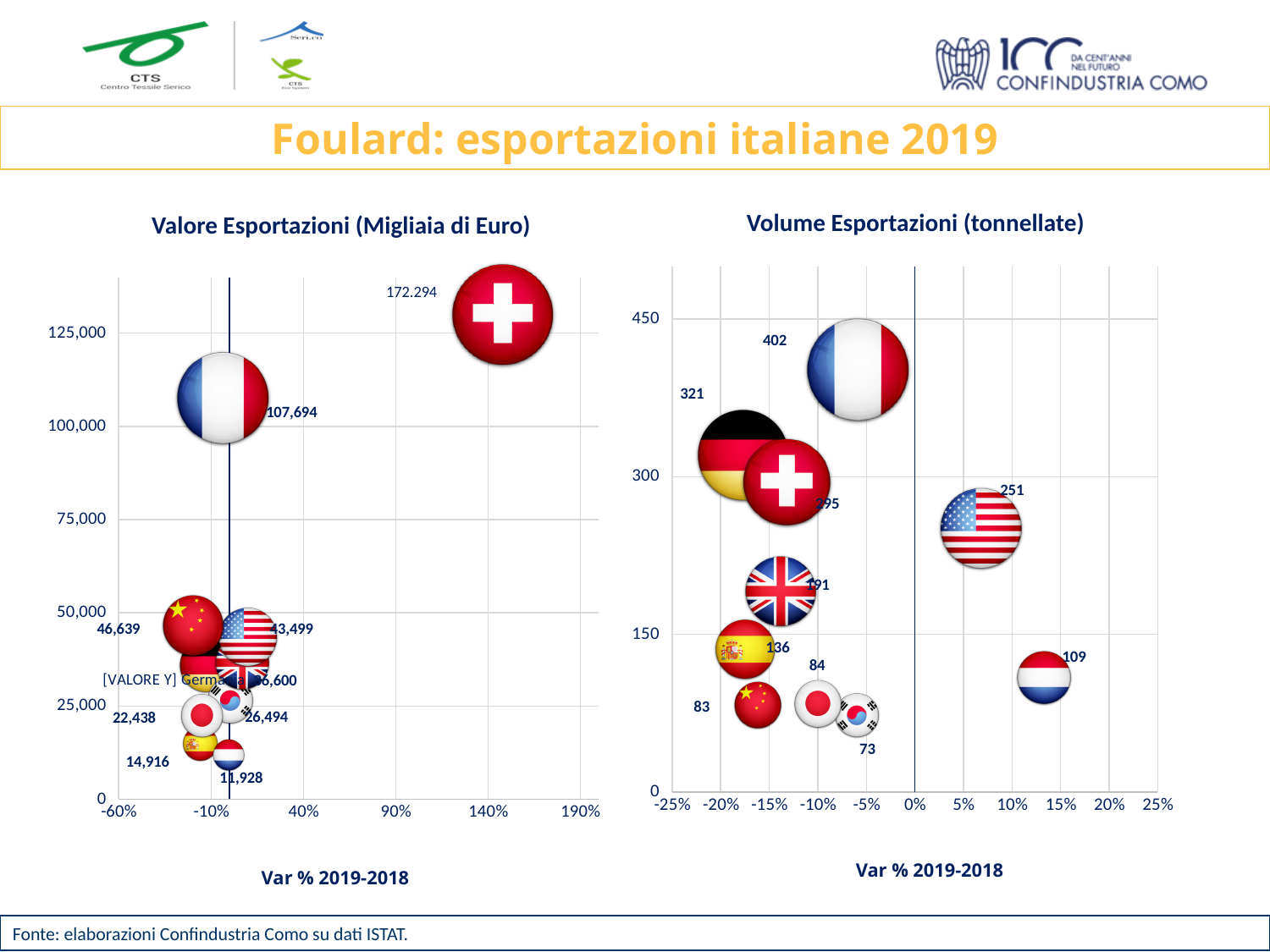
In the 'Volume Esportazioni (tonnellate)' chart, what is the value for the United States flag bubble? 251 What kind of chart is the 'Volume Esportazioni (tonnellate)' chart on the right? bubble chart In the 'Volume Esportazioni (tonnellate)' chart, what is the highest value shown? 402 In the 'Volume Esportazioni (tonnellate)' chart, which is larger: the United Kingdom bubble or the Spain bubble? United Kingdom What is the x-axis title of the 'Volume Esportazioni (tonnellate)' chart? Var % 2019-2018 In the 'Volume Esportazioni (tonnellate)' chart, what is the value for the Netherlands flag bubble? 109 In the 'Volume Esportazioni (tonnellate)' chart, is the Var % value for the United States bubble greater or less than 0%? greater In the 'Valore Esportazioni (Migliaia di Euro)' chart, what is the value labelled next to the French flag bubble? 107,694 In the 'Valore Esportazioni (Migliaia di Euro)' chart, what is the highest value shown? 172.294 In the 'Volume Esportazioni (tonnellate)' chart, what is the difference between the France bubble (402) and the Germany bubble (321)? 81 In the 'Volume Esportazioni (tonnellate)' chart, what is the lowest value shown? 73 In the 'Valore Esportazioni (Migliaia di Euro)' chart, what is the lowest labelled value? 11,928